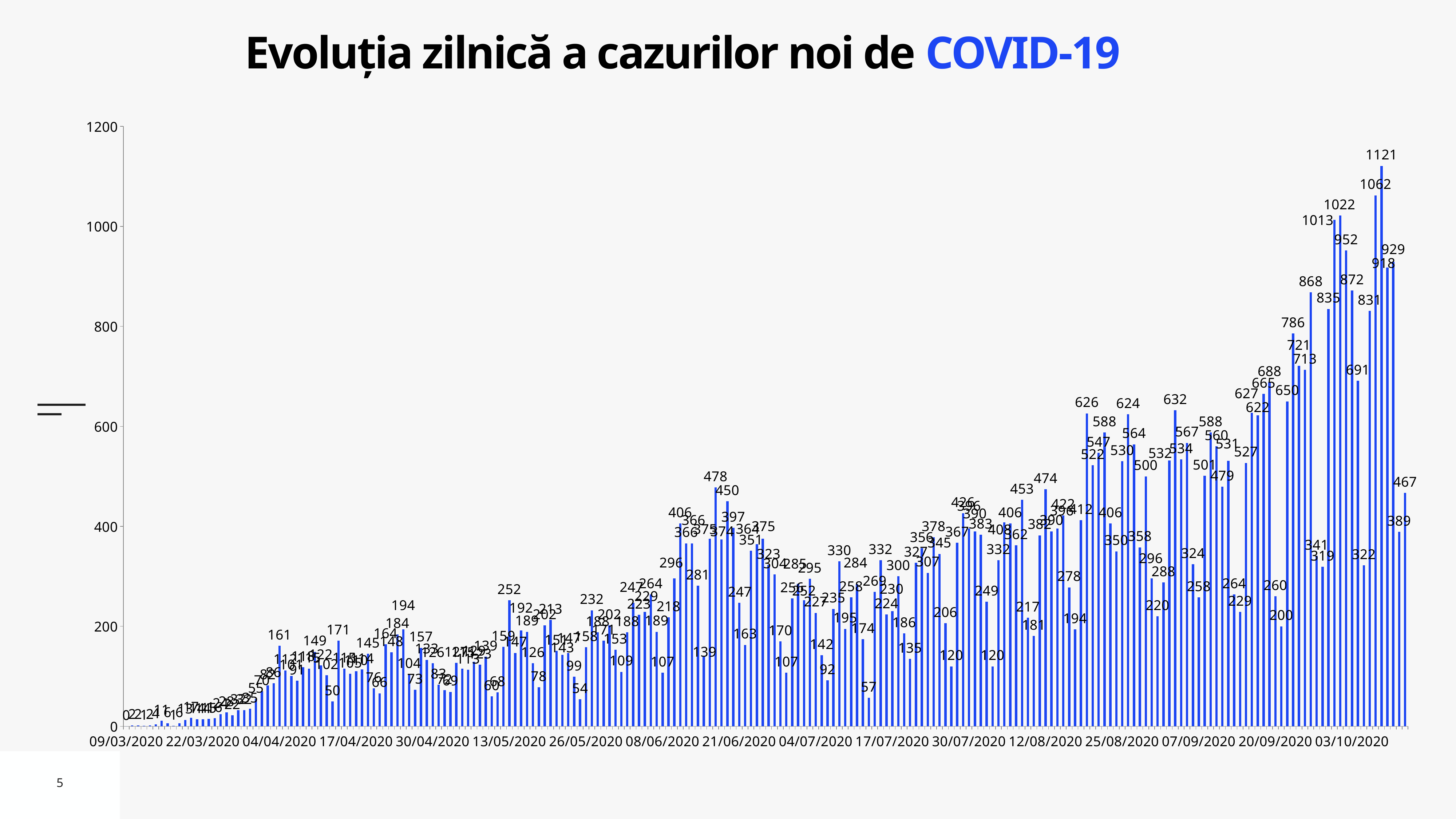
What is the second highest daily value labelled on the chart? 1062 What is the highest tick value shown on the y axis? 1200 Overall, do the daily values rise or fall from left to right along the x axis? rise What is the value of the first bar, at 09/03/2020? 0 Is the tallest bar greater or less than 1000? greater What is the highest daily value shown on the chart? 1121 What kind of chart is shown on the slide? bar chart What is the difference between the two highest values, 1121 and 1062? 59 What is the value of the last (rightmost) bar on the chart? 467 What is the title of the chart? Evoluția zilnică a cazurilor noi de COVID-19 Is the value of the rightmost bar greater or less than 600? less Which is larger, the bar labelled 1121 or the bar labelled 1062? 1121